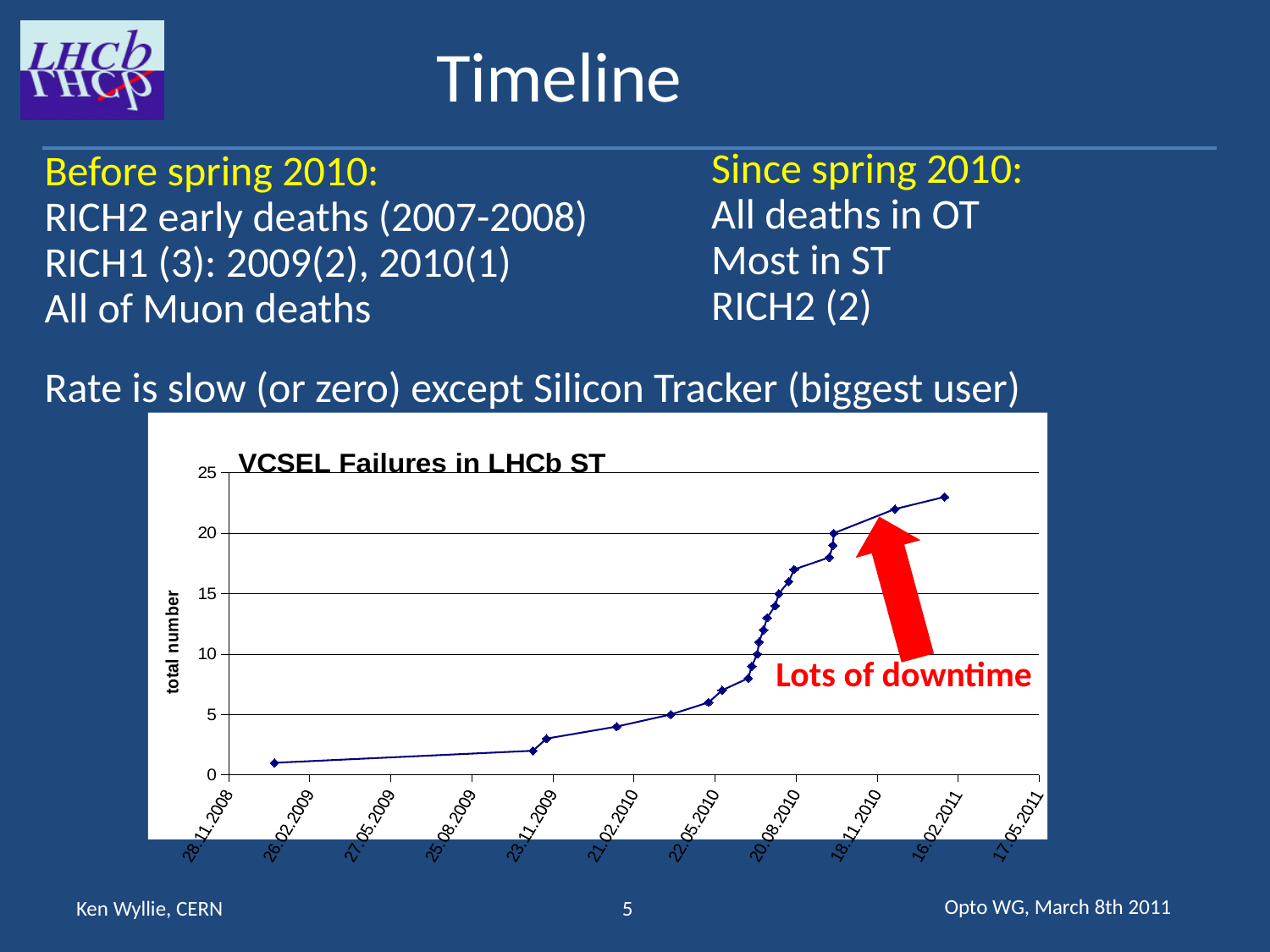
What text does the red annotation next to the arrow on the chart say? Lots of downtime Is the value of the first plotted point (near 28.11.2008) greater or less than 5? less What is the title of the chart? VCSEL Failures in LHCb ST Which is larger, the value plotted near 20.08.2010 or the value plotted near 21.02.2010? 20.08.2010 Is the value plotted near 22.05.2010 greater or less than 10? less What kind of chart is shown on the slide? line chart Is the value of the last plotted point (early 2011) greater or less than 20? greater At which end of the x axis does the chart reach its highest value, the left (2008) or the right (2011)? right (2011) Do the values in the chart rise or fall along the x axis from 28.11.2008 to 2011? rise